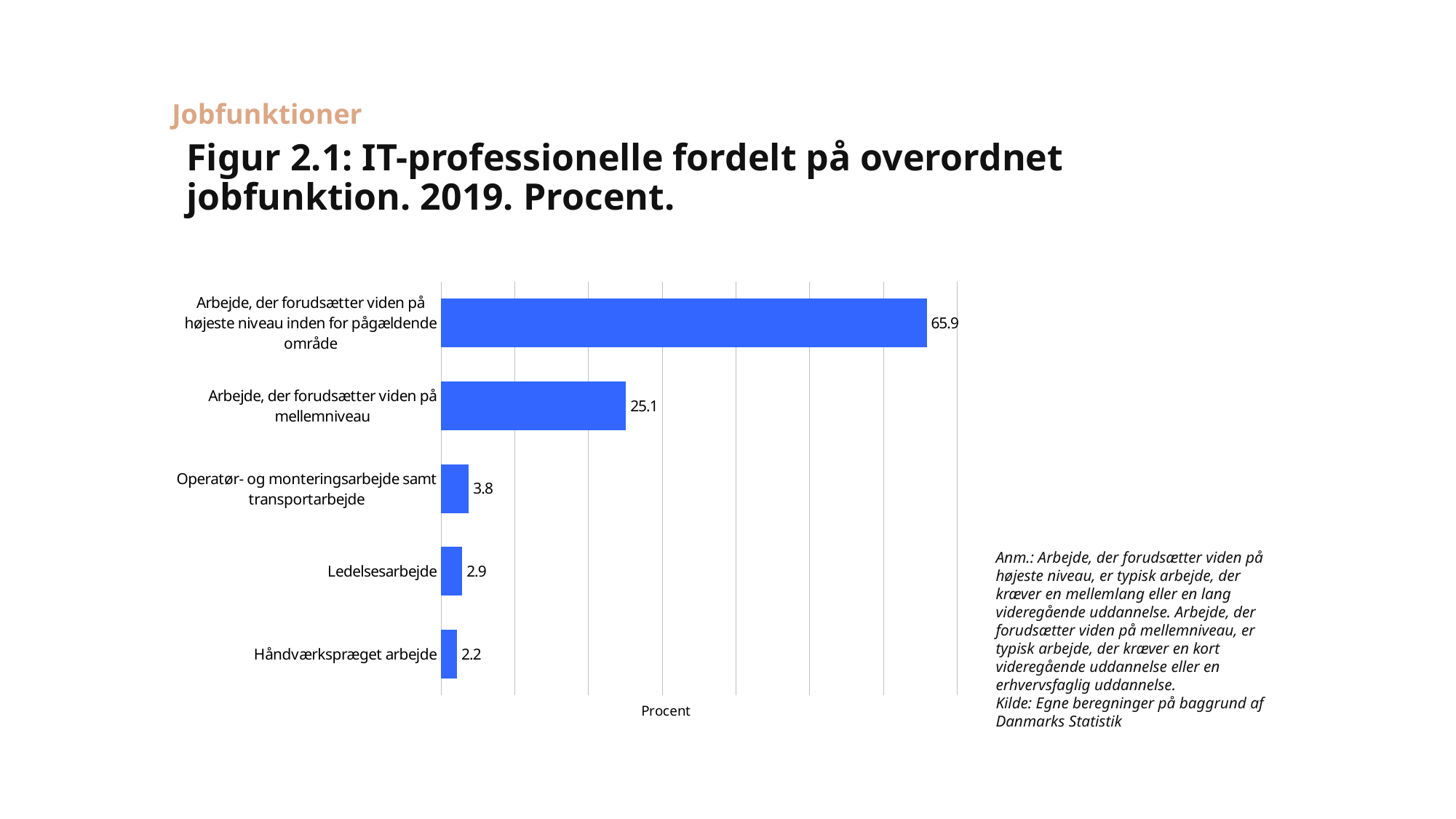
Which category has the highest value? Arbejde, der forudsætter viden på højeste niveau inden for pågældende område What is the value for "Arbejde, der forudsætter viden på mellemniveau"? 25.1 What kind of chart is shown on the slide? Bar chart What is the label on the horizontal axis of the chart? Procent What is the value for "Arbejde, der forudsætter viden på højeste niveau inden for pågældende område"? 65.9 What is the value for "Operatør- og monteringsarbejde samt transportarbejde"? 3.8 What is the difference between the values for "Arbejde, der forudsætter viden på højeste niveau inden for pågældende område" and "Arbejde, der forudsætter viden på mellemniveau"? 40.8 What is the value for "Håndværkspræget arbejde"? 2.2 What is the value for "Ledelsesarbejde"? 2.9 Which is larger, the value for "Ledelsesarbejde" or the value for "Operatør- og monteringsarbejde samt transportarbejde"? Operatør- og monteringsarbejde samt transportarbejde Which category has the lowest value? Håndværkspræget arbejde How many categories are shown in the chart? 5